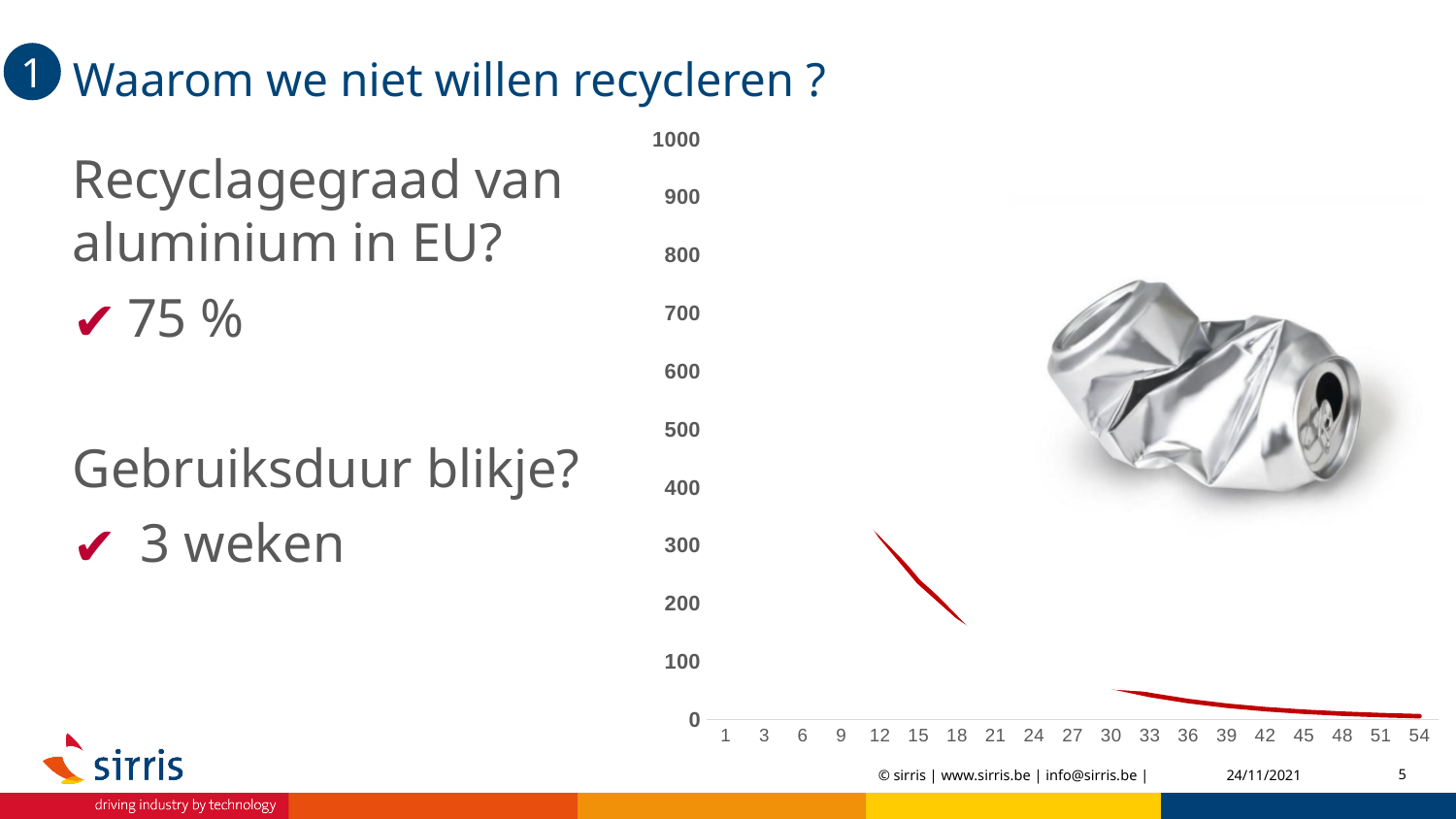
Is the value at x = 36 greater or less than 100? less Which is larger, the value at x = 18 or the value at x = 54? x = 18 Do the values on the chart rise or fall as you move along the x axis? fall Is the value at x = 15 greater or less than 100? greater What is the highest value shown on the y axis? 1000 Is the value at x = 18 greater or less than 200? less What kind of chart is shown on the slide? line chart Which is larger, the value at x = 15 or the value at x = 36? x = 15 What colour is the plotted line? red How many tick labels are shown on the x axis? 19